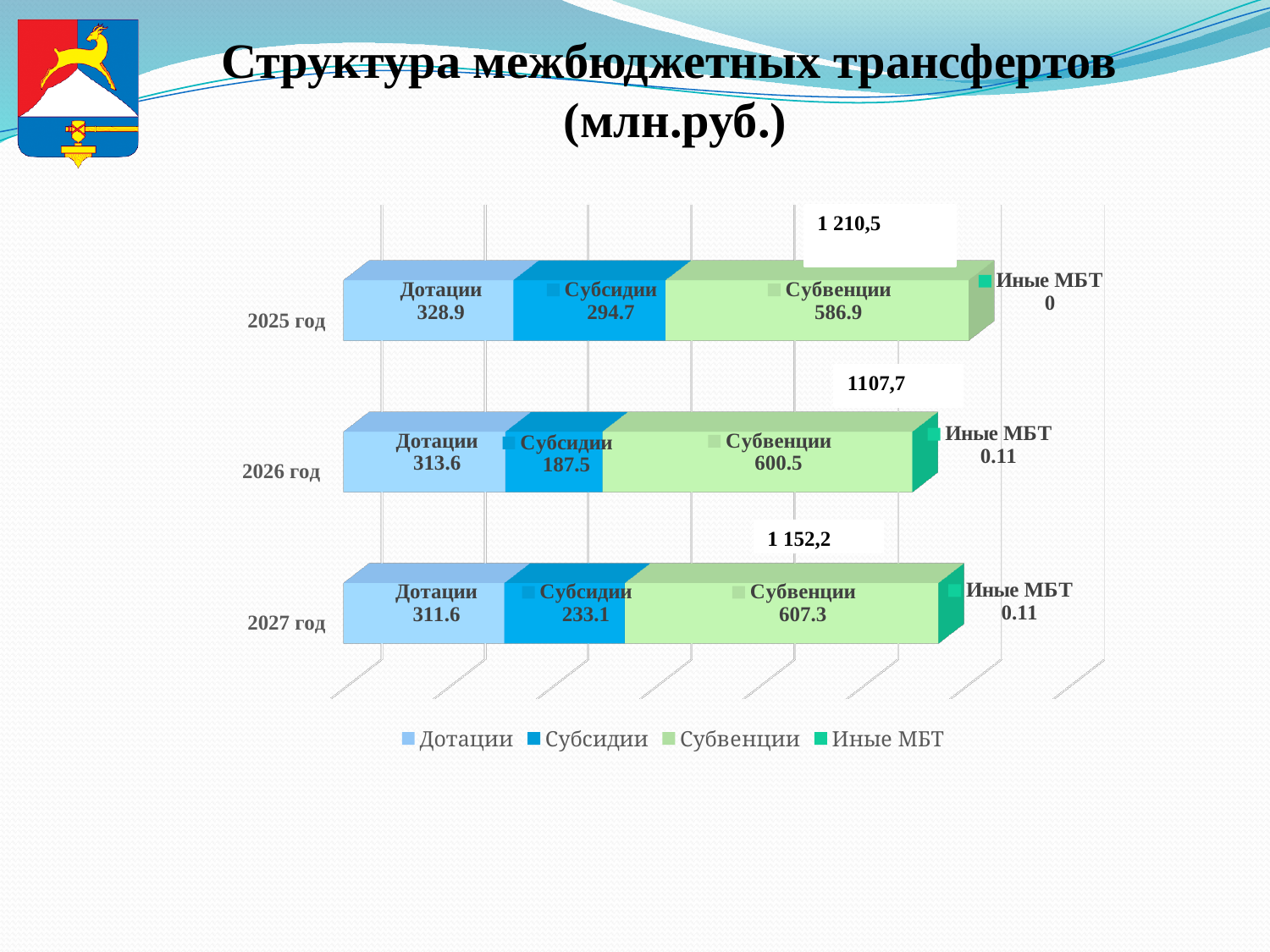
How many series does the legend list? 4 How many years are shown on the chart? 3 Which year has the larger value for Субсидии, 2025 год or 2027 год? 2025 год Do the values for Дотации rise or fall from 2025 год to 2027 год? fall What is the value of Иные МБТ for 2025 год? 0 What is the difference between Дотации in 2025 год and Дотации in 2027 год? 17.3 Which year has the lowest value for Субсидии? 2026 год What is the value of Субсидии for 2026 год? 187.5 What is the value of Дотации for 2025 год? 328.9 Which year has the highest value for Субвенции? 2027 год What is the value of Субвенции for 2027 год? 607.3 What total is printed above the bar for 2025 год? 1 210,5